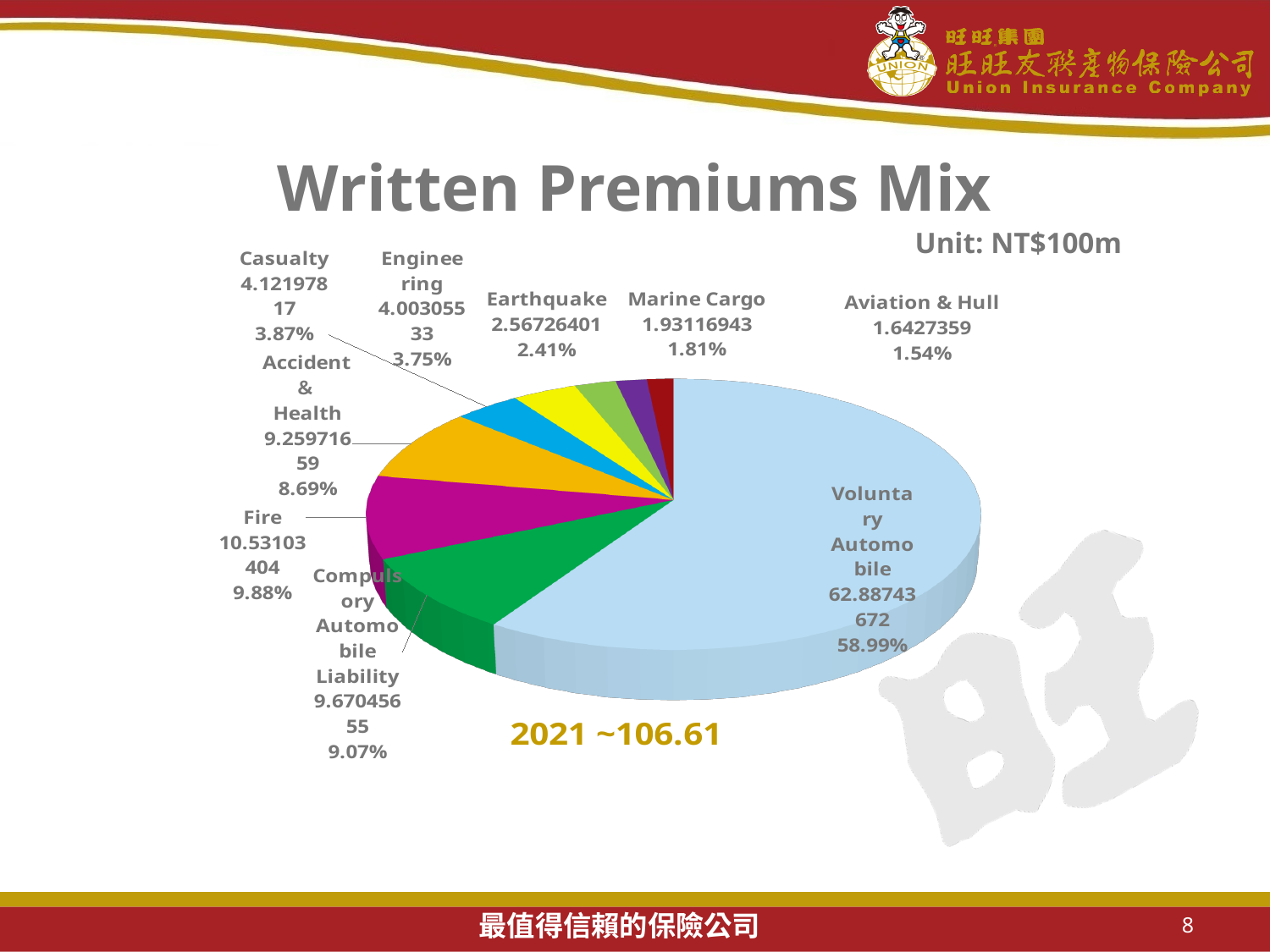
What share of the pie does Voluntary Automobile represent? 58.99% Which category has the largest slice of the pie? Voluntary Automobile What is the total written premium shown for 2021? ~106.61 What is the difference in percentage share between Fire and Accident & Health? 1.19% What is the written premium value for Fire? 10.53103404 What is the title of the chart? Written Premiums Mix What share of the pie does Compulsory Automobile Liability represent? 9.07% Which category has the smallest slice of the pie? Aviation & Hull Which is larger, the share for Fire or the share for Accident & Health? Fire How many categories (slices) does the pie chart have? 9 What kind of chart is shown on the slide? Pie chart What unit is stated for the chart values? NT$100m